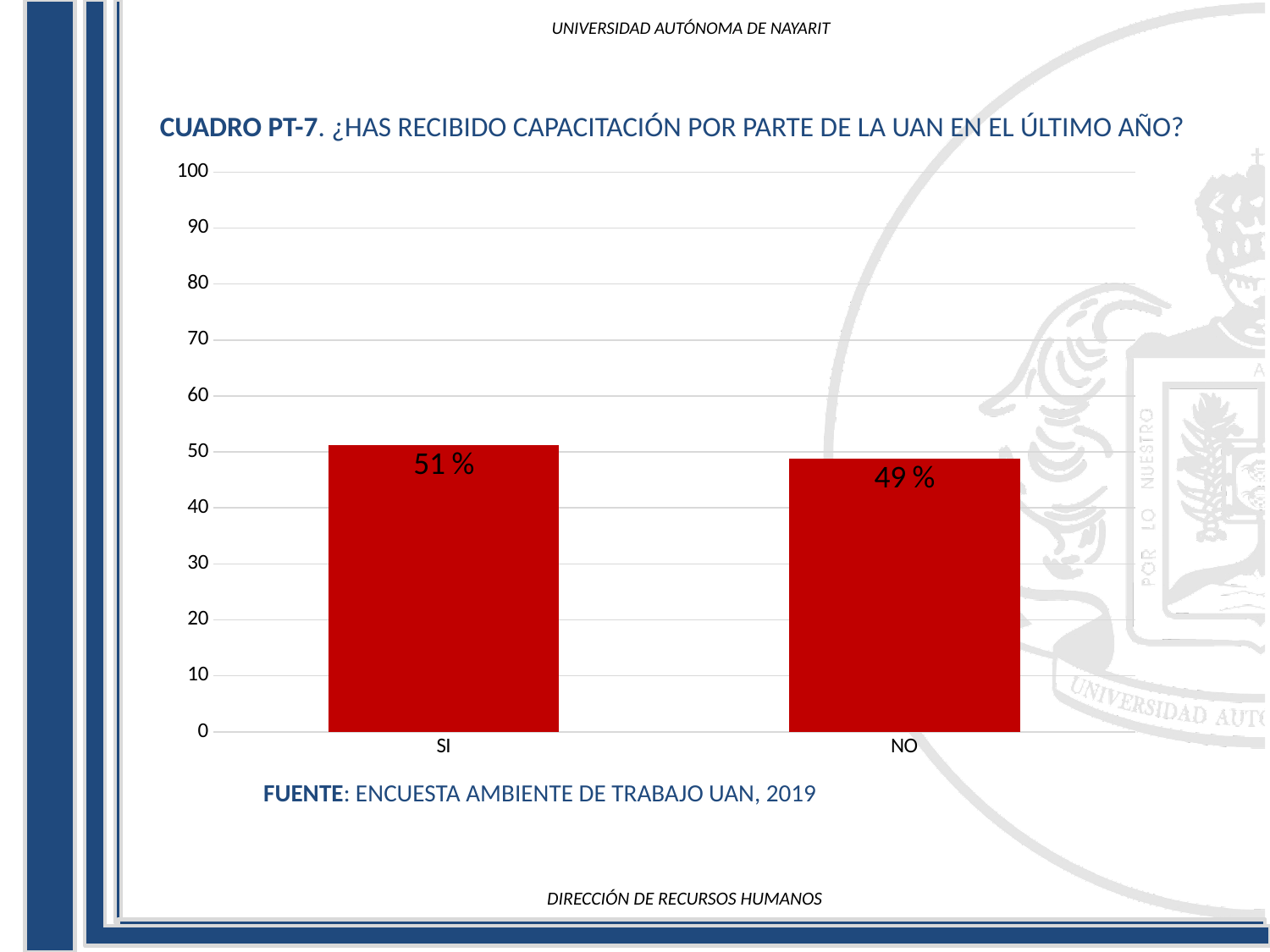
What is the title of the chart? CUADRO PT-7. ¿HAS RECIBIDO CAPACITACIÓN POR PARTE DE LA UAN EN EL ÚLTIMO AÑO? Which category has the lowest value? NO Is the value for NO greater or less than 40? greater What is the value for NO? 49 % Which category has the highest value? SI Is the value for SI greater or less than 60? less What is the difference between the values for SI and NO? 2 % How many categories are shown on the x axis? 2 What kind of chart is shown on the slide? bar chart What is the value for SI? 51 % Which is larger, the value for SI or the value for NO? SI What source is cited below the chart? ENCUESTA AMBIENTE DE TRABAJO UAN, 2019